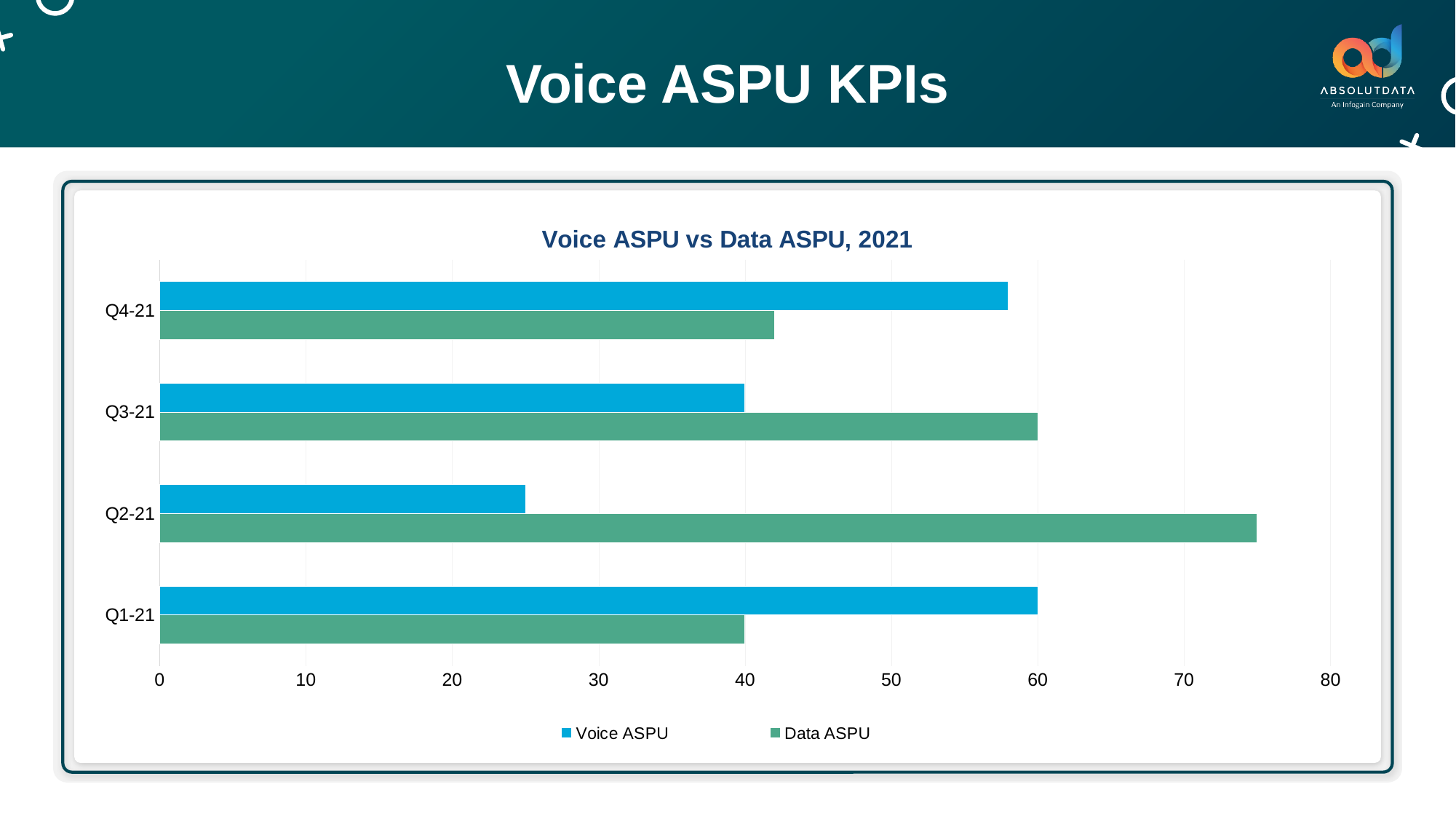
How many series does the legend list? 2 What kind of chart is shown on the slide? bar chart What is the Data ASPU value for Q3-21? 60 What is the Voice ASPU value for Q1-21? 60 How many quarters are shown on the chart? 4 In Q3-21, which is larger, Voice ASPU or Data ASPU? Data ASPU What is the title of the chart? Voice ASPU vs Data ASPU, 2021 Which quarter has the highest Data ASPU? Q2-21 Is the Data ASPU value for Q2-21 greater or less than 70? greater Is the Voice ASPU value for Q4-21 greater or less than 50? greater Is the Voice ASPU value for Q2-21 greater or less than 30? less Which quarter has the lowest Voice ASPU? Q2-21